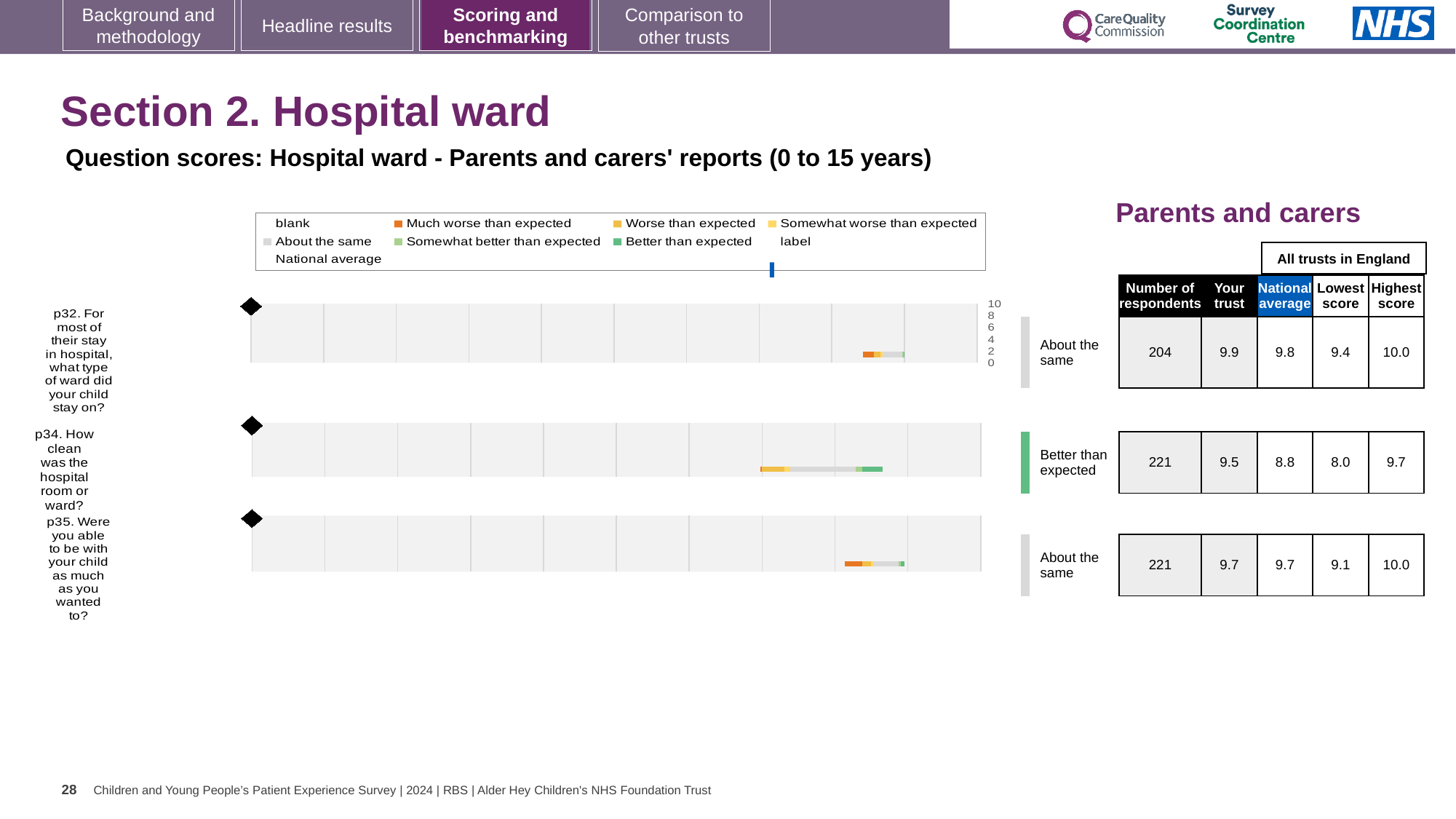
What is the 'Your trust' score for p34 (How clean was the hospital room or ward?)? 9.5 How many questions (bars) are plotted in the chart? 3 Which question has the lowest 'Your trust' score? p34 Which question has the highest 'Your trust' score? p32 Which question is rated 'Better than expected' in the chart? p34 How many respondents answered p35 (Were you able to be with your child as much as you wanted to?)? 221 For p32, which is larger: the 'Your trust' score or the national average? Your trust What kind of chart is used to show the question scores on this slide? bar chart What is the national average score for p34 (How clean was the hospital room or ward?)? 8.8 What is the 'Your trust' score for p32 (what type of ward did your child stay on?)? 9.9 What is the difference between the 'Your trust' score and the national average for p34? 0.7 What is the lowest score across all trusts in England for p35? 9.1